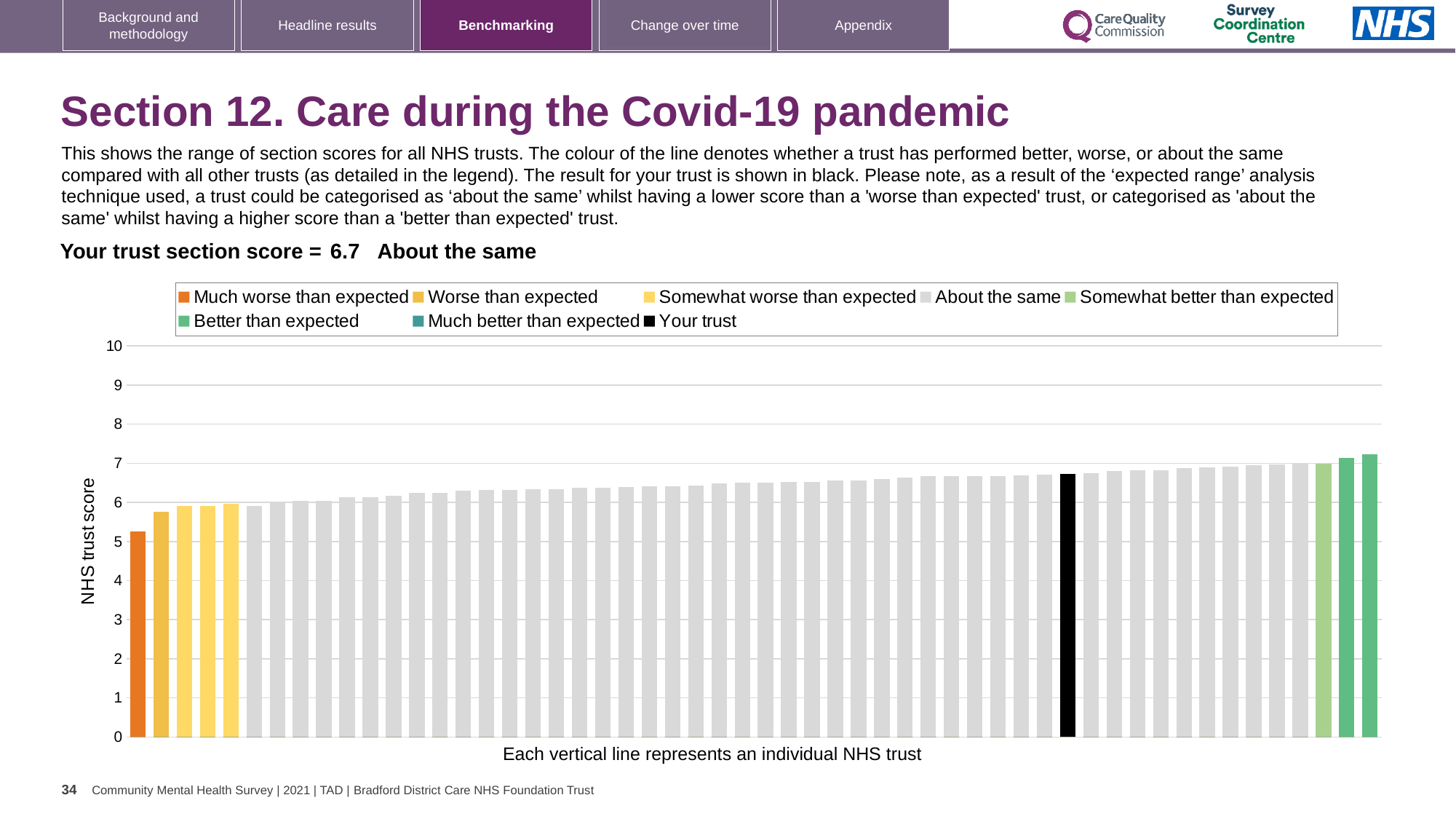
Is the value of the leftmost (orange) bar greater or less than 6? less What kind of chart is shown on the slide? Bar chart What is the label on the vertical axis of the chart? NHS trust score How many entries does the chart legend list? 8 What is the section score for your trust shown on the slide? 6.7 Which legend category does the highest bar on the chart belong to? Better than expected How is your trust's section score categorised compared with other trusts? About the same Is the value of the leftmost (orange) bar greater or less than 5? greater Is the value of the rightmost bar greater or less than 7? greater Do the bar values rise or fall from left to right along the x axis? Rise Which legend category does the lowest bar on the chart belong to? Much worse than expected